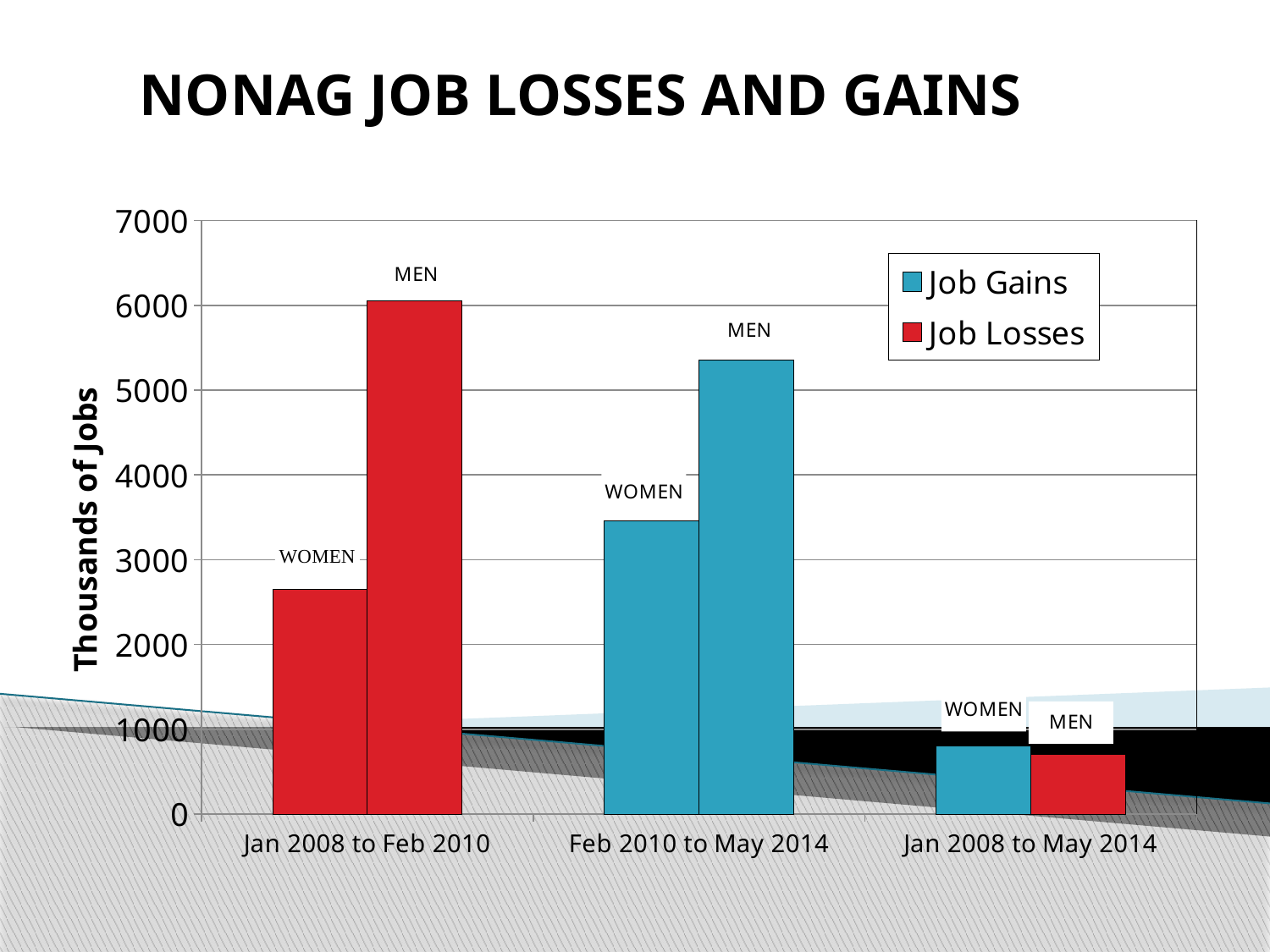
What is the title of the chart? NONAG JOB LOSSES AND GAINS How many series does the legend list? 2 In Feb 2010 to May 2014, which is larger, the value for MEN or the value for WOMEN? MEN Which bar is the tallest on the chart? MEN, Jan 2008 to Feb 2010 Is the value for MEN in Feb 2010 to May 2014 greater or less than 5000? greater Is the value for WOMEN in Jan 2008 to May 2014 greater or less than 1000? less Is the value for WOMEN in Jan 2008 to Feb 2010 greater or less than 3000? less What kind of chart is shown on the slide? bar chart How many time-period categories are shown on the x axis? 3 What is the label on the y axis? Thousands of Jobs